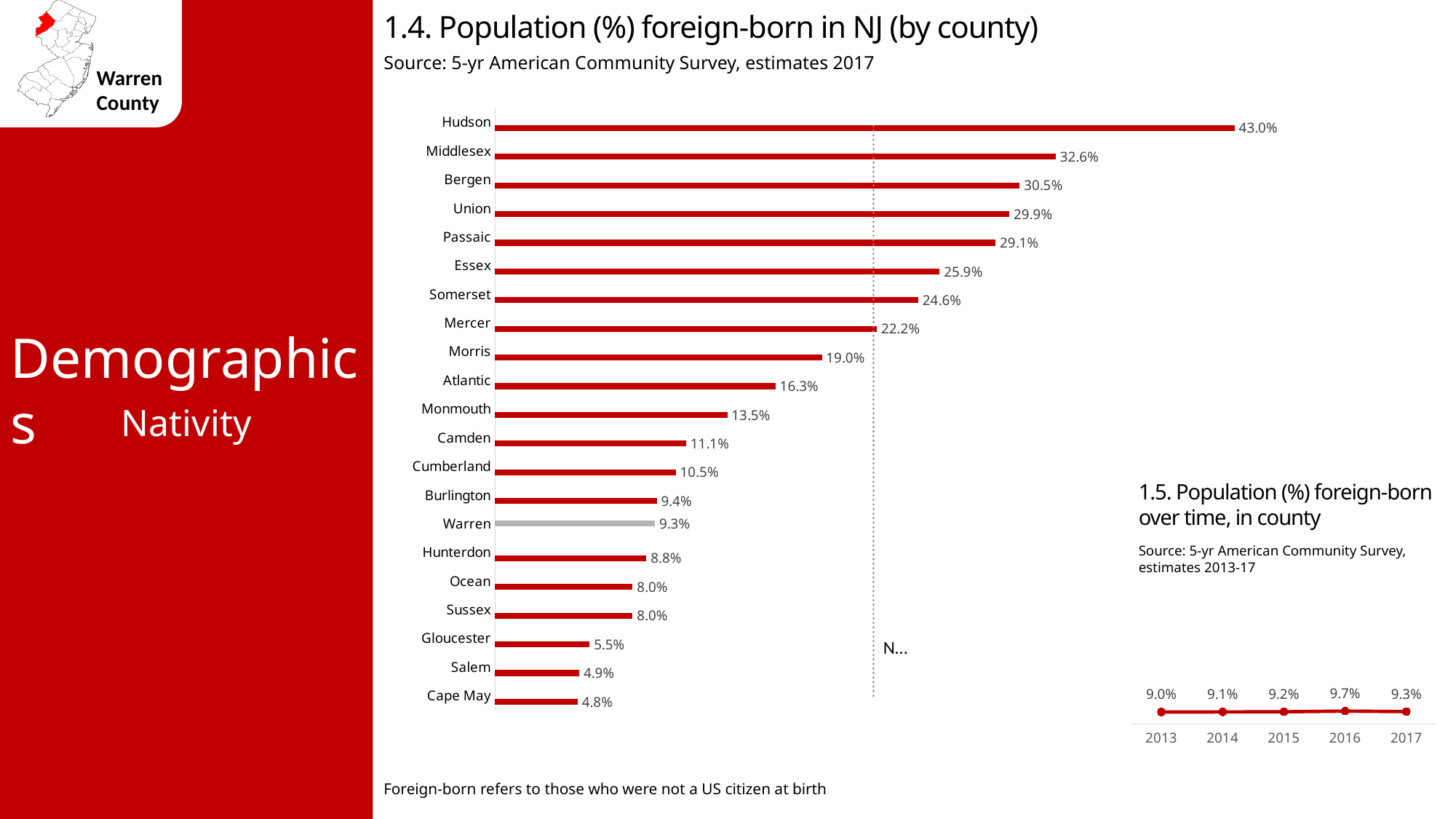
In the chart '1.4. Population (%) foreign-born in NJ (by county)', what is the value for Warren? 9.3% In the chart '1.4. Population (%) foreign-born in NJ (by county)', which county has the highest value? Hudson In the chart '1.4. Population (%) foreign-born in NJ (by county)', which is larger, Burlington or Hunterdon? Burlington In the chart '1.5. Population (%) foreign-born over time, in county', which year has the lowest value? 2013 In the chart '1.4. Population (%) foreign-born in NJ (by county)', which county has the lowest value? Cape May How many counties are shown in the chart '1.4. Population (%) foreign-born in NJ (by county)'? 21 What kind of chart is '1.4. Population (%) foreign-born in NJ (by county)'? Bar chart In the chart '1.4. Population (%) foreign-born in NJ (by county)', which bar is coloured grey instead of red? Warren In the chart '1.4. Population (%) foreign-born in NJ (by county)', what is the value for Middlesex? 32.6% In the chart '1.5. Population (%) foreign-born over time, in county', what is the value for 2016? 9.7% How many data points are plotted in the chart '1.5. Population (%) foreign-born over time, in county'? 5 In the chart '1.4. Population (%) foreign-born in NJ (by county)', what is the difference between Hudson and Warren? 33.7%